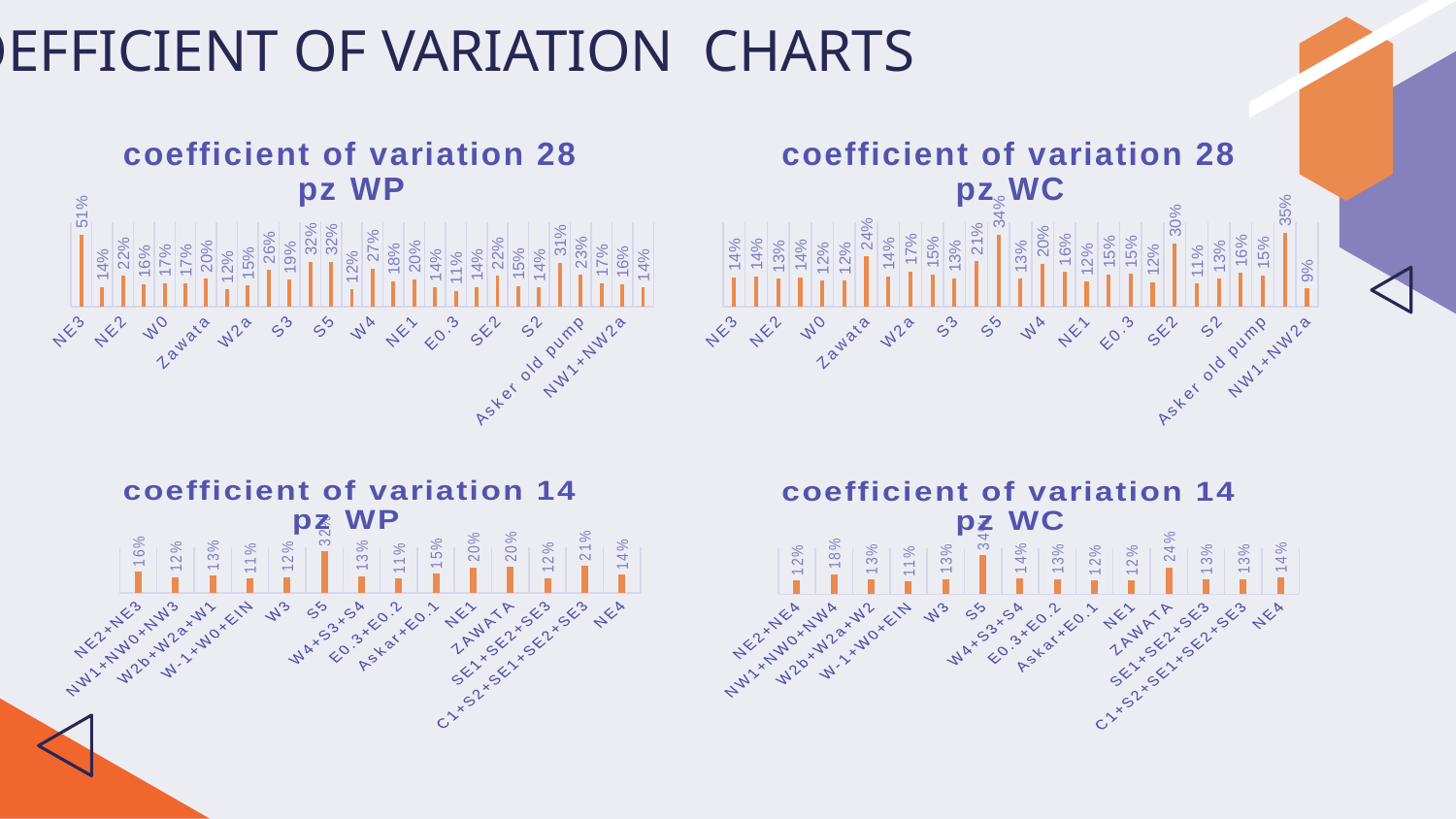
In the 'coefficient of variation 14 pz WC' chart, what is the value for ZAWATA? 24% In the 'coefficient of variation 28 pz WC' chart, what is the highest value shown? 35% In the 'coefficient of variation 14 pz WP' chart, how many categories are plotted? 14 In the 'coefficient of variation 28 pz WP' chart, which category has the highest value? NE3 In the 'coefficient of variation 14 pz WP' chart, what is the value for S5? 32% What type of chart is the 'coefficient of variation 14 pz WP' chart? Bar chart In the 'coefficient of variation 14 pz WC' chart, which category has the highest value? S5 In the 'coefficient of variation 28 pz WP' chart, what is the value for NE3? 51% In the 'coefficient of variation 14 pz WC' chart, what is the difference between S5 and NE4? 20% In the 'coefficient of variation 28 pz WC' chart, what is the lowest value shown? 9% In the 'coefficient of variation 14 pz WP' chart, what is the value for NE1? 20% In the 'coefficient of variation 14 pz WC' chart, which is larger, NW1+NW0+NW4 or W3? NW1+NW0+NW4